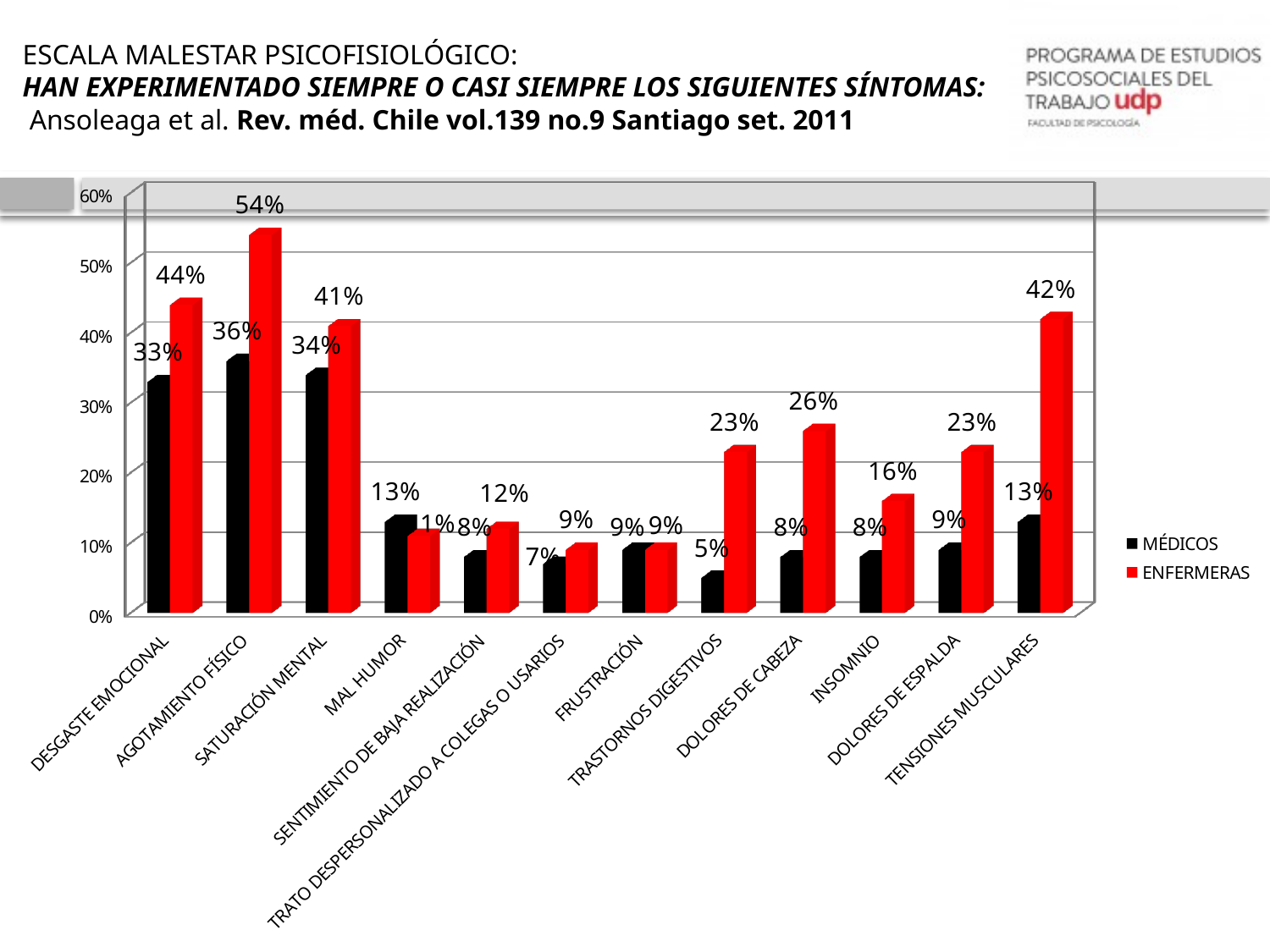
What is the value for ENFERMERAS for AGOTAMIENTO FÍSICO? 54% Which category has the lowest value for MÉDICOS? TRASTORNOS DIGESTIVOS What type of chart is shown on the slide? bar chart Which is larger for INSOMNIO, the MÉDICOS value or the ENFERMERAS value? ENFERMERAS What is the value for ENFERMERAS for TENSIONES MUSCULARES? 42% Which series is shown in red in the legend? ENFERMERAS How many series does the legend list? 2 What is the difference between the ENFERMERAS and MÉDICOS values for DOLORES DE CABEZA? 18% Which category has the highest value for ENFERMERAS? AGOTAMIENTO FÍSICO What is the value for MÉDICOS for DESGASTE EMOCIONAL? 33% How many symptom categories are shown on the x axis? 12 What is the value for MÉDICOS for TRASTORNOS DIGESTIVOS? 5%